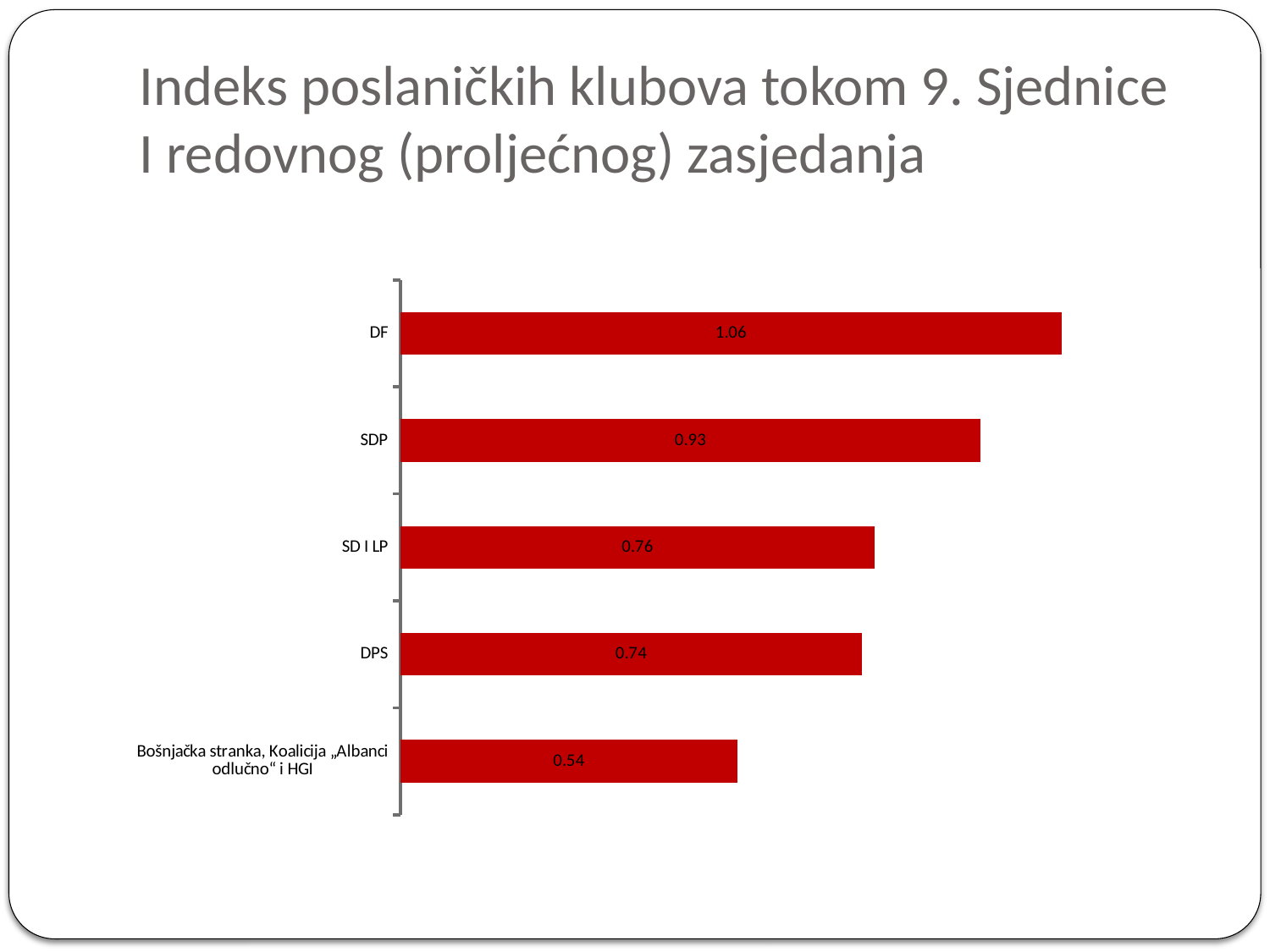
Which club has the lowest index value? Bošnjačka stranka, Koalicija „Albanci odlučno“ i HGI What is the index value for SDP? 0.93 Which club has the highest index value? DF What is the index value for Bošnjačka stranka, Koalicija „Albanci odlučno“ i HGI? 0.54 What is the index value for SD I LP? 0.76 Which has a larger index value, SDP or DPS? SDP What is the index value for DPS? 0.74 What is the difference between the index values of SD I LP and DPS? 0.02 What is the index value for DF? 1.06 What is the difference between the index values of DF and SDP? 0.13 What kind of chart is shown on the slide? Bar chart How many clubs are shown in the chart? 5